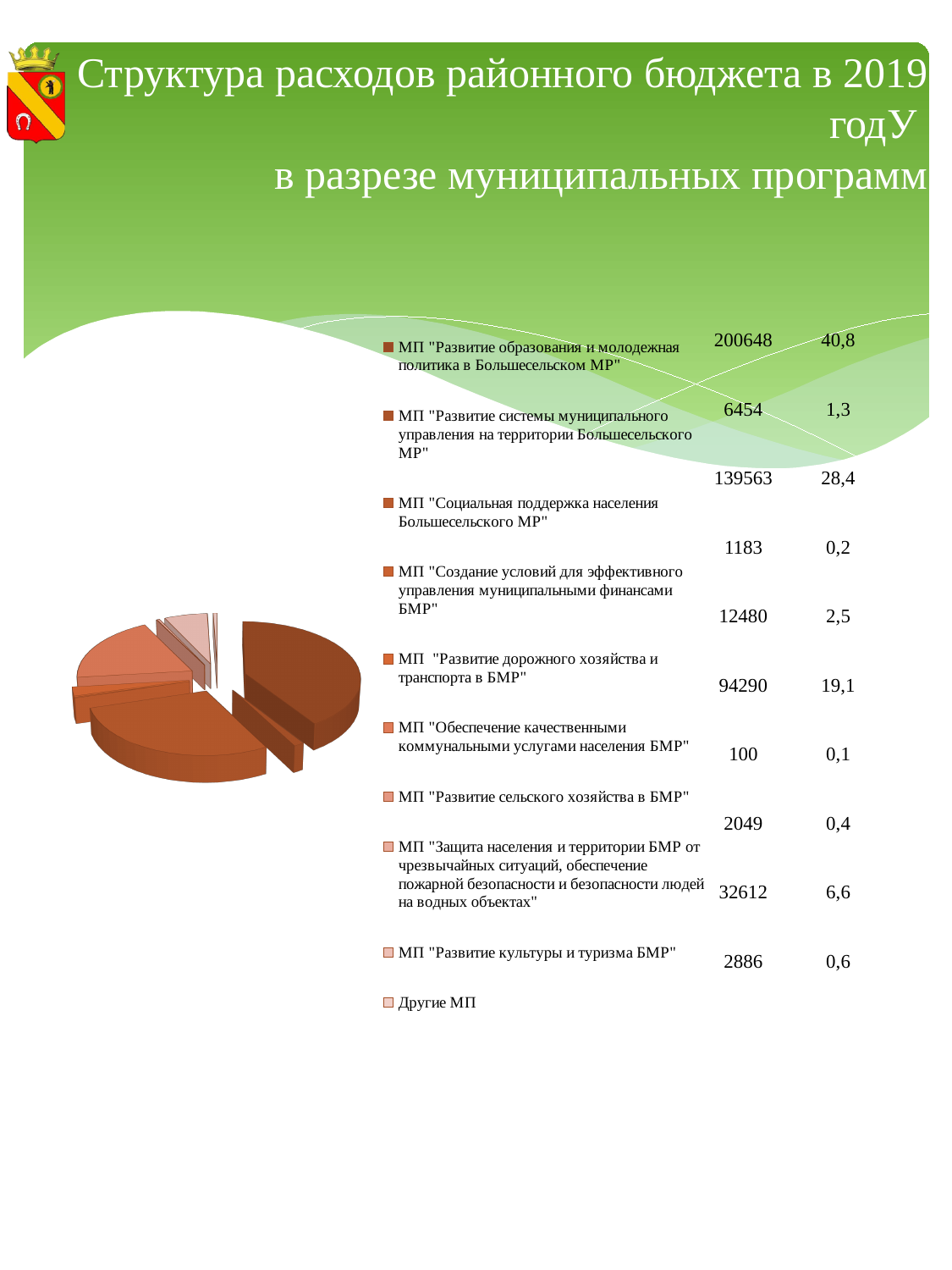
Which has the larger expenditure: МП "Развитие образования и молодежная политика в Большесельском МР" or МП "Социальная поддержка населения Большесельского МР"? МП "Развитие образования и молодежная политика в Большесельском МР" What is the expenditure value shown for МП "Развитие культуры и туризма БМР"? 32612 What percentage share is shown for МП "Социальная поддержка населения Большесельского МР"? 28,4 What is the difference between the expenditure for МП "Развитие образования и молодежная политика в Большесельском МР" (200648) and МП "Социальная поддержка населения Большесельского МР" (139563)? 61085 Which municipal program has the largest share of district budget expenditure in 2019? МП "Развитие образования и молодежная политика в Большесельском МР" What is the title of the slide containing the pie chart? Структура расходов районного бюджета в 2019 году в разрезе муниципальных программ What percentage share is shown for МП "Развитие системы муниципального управления на территории Большесельского МР"? 1,3 What kind of chart is shown on the slide? Pie chart What percentage share is shown for МП "Развитие образования и молодежная политика в Большесельском МР"? 40,8 What is the expenditure value shown for МП "Развитие образования и молодежная политика в Большесельском МР"? 200648 How many entries does the legend of the pie chart list? 10 What is the expenditure value shown for МП "Развитие системы муниципального управления на территории Большесельского МР"? 6454